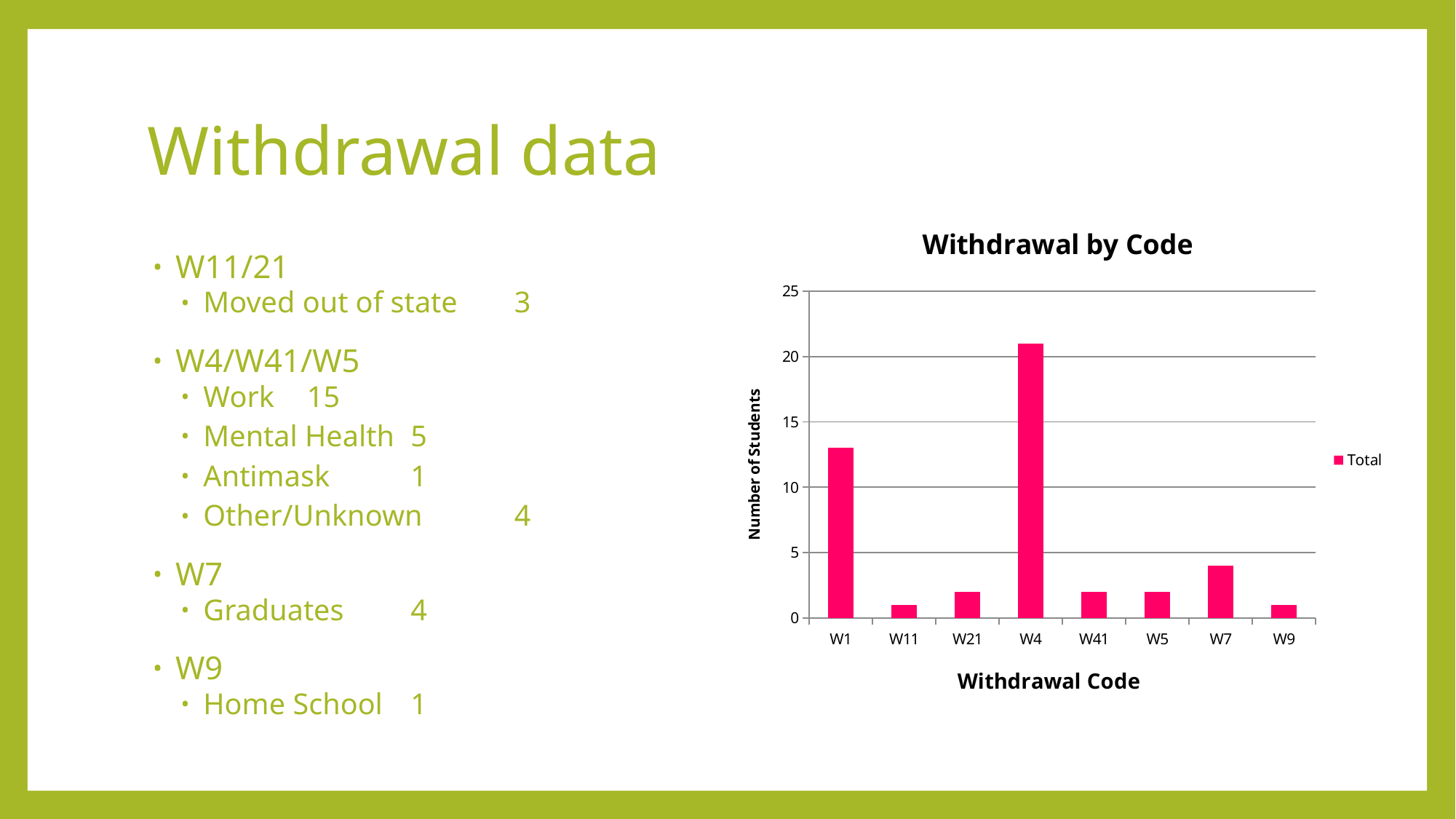
What is the label on the vertical axis of the chart? Number of Students How many series does the legend list? 1 What is the title of the chart? Withdrawal by Code Which has more students, W4 or W1? W4 Which withdrawal code has the highest number of students? W4 What kind of chart is shown on the slide? bar chart Is the value for W1 greater or less than 10? greater Is the value for W4 greater or less than 20? greater Is the value for W1 greater or less than 15? less Which has more students, W1 or W7? W1 How many withdrawal codes are shown on the x axis? 8